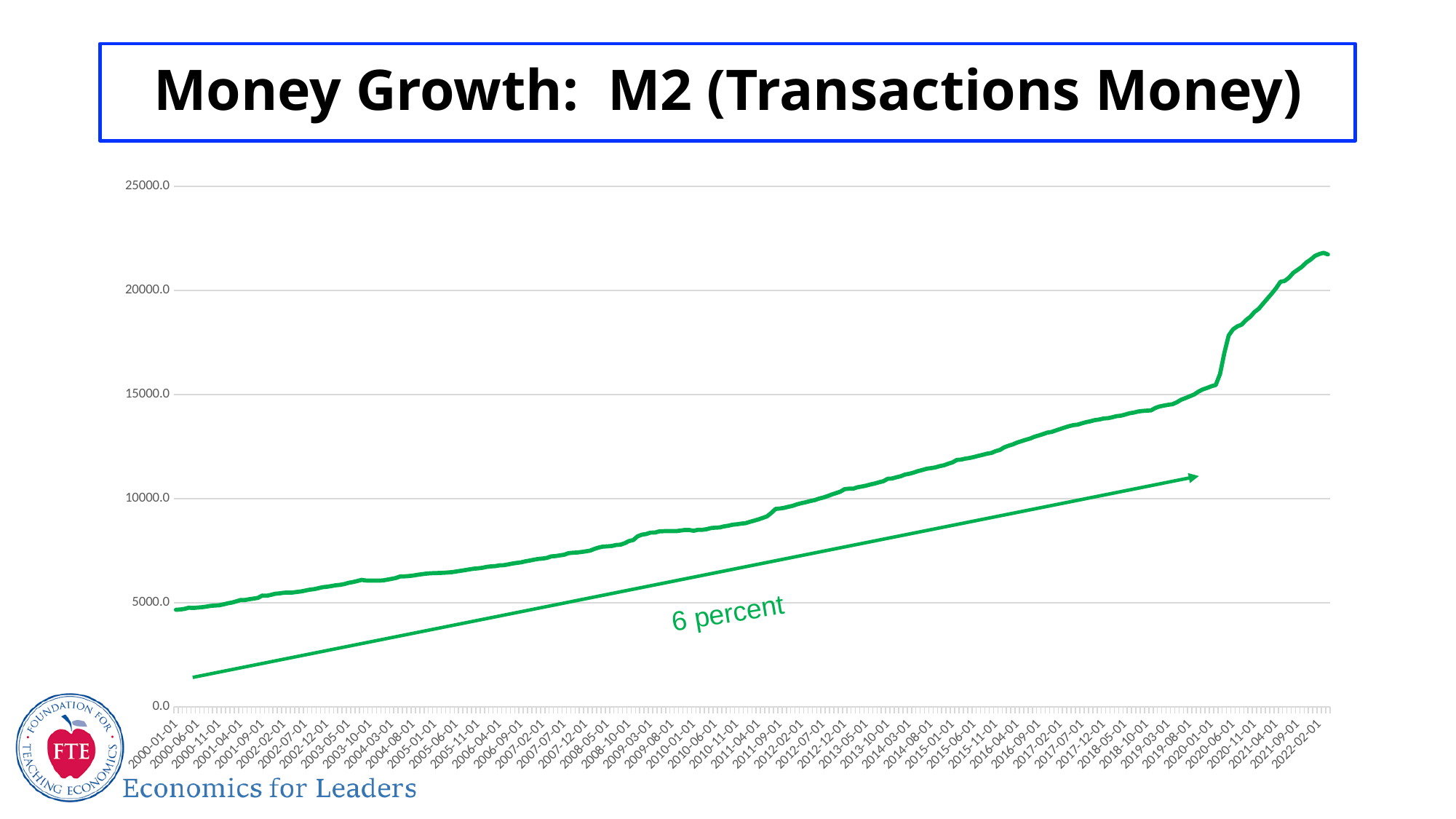
Is the M2 value at 2015-01-01 greater or less than 10000.0? greater Which date has the higher M2 value, 2008-05-01 or 2018-05-01? 2018-05-01 What is the title of the slide containing the chart? Money Growth: M2 (Transactions Money) What kind of chart is shown on the slide? line chart Is the M2 value at 2022-02-01 greater or less than 20000.0? greater Which date has the higher M2 value, 2000-01-01 or 2022-02-01? 2022-02-01 At which end of the x axis does the M2 line reach its lowest value, the start (2000-01-01) or the end (2022-02-01)? the start (2000-01-01) Is the M2 value at 2005-01-01 greater or less than 5000.0? greater What growth rate is labelled on the straight reference arrow drawn below the M2 line? 6 percent Do the M2 values generally rise or fall from 2000-01-01 to 2022-02-01? rise